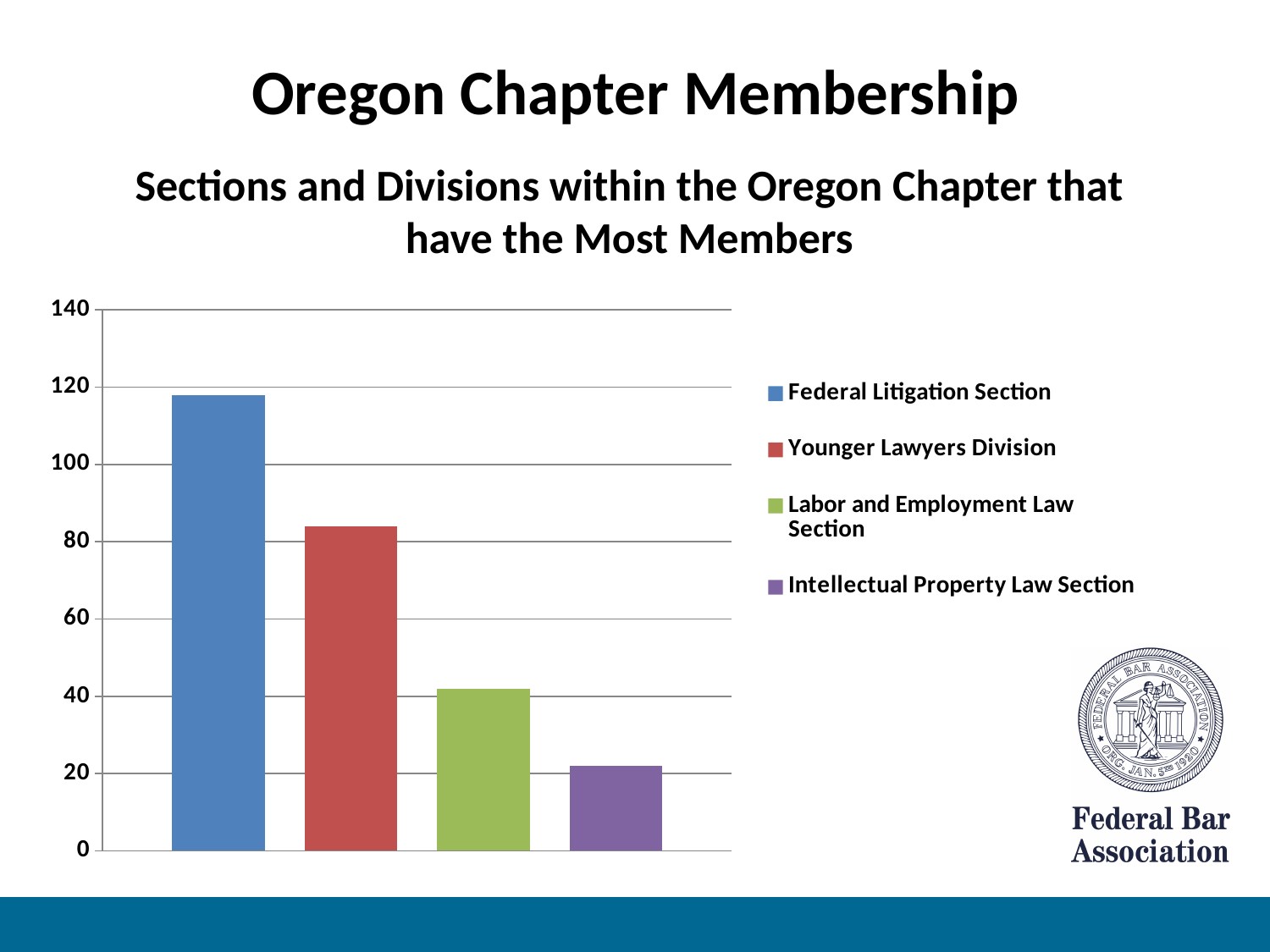
How many bars are plotted in the chart? 4 Which section or division has the fewest members according to the chart? Intellectual Property Law Section Which section or division has the most members according to the chart? Federal Litigation Section How many entries does the chart's legend list? 4 What kind of chart is shown on the slide? bar chart Is the value for the Federal Litigation Section greater or less than 100? greater Is the value for the Younger Lawyers Division greater or less than 100? less Which has more members, the Younger Lawyers Division or the Labor and Employment Law Section? Younger Lawyers Division What colour is the bar for the Younger Lawyers Division? red Is the value for the Intellectual Property Law Section greater or less than 40? less Do the bar values rise or fall from left to right across the chart? fall